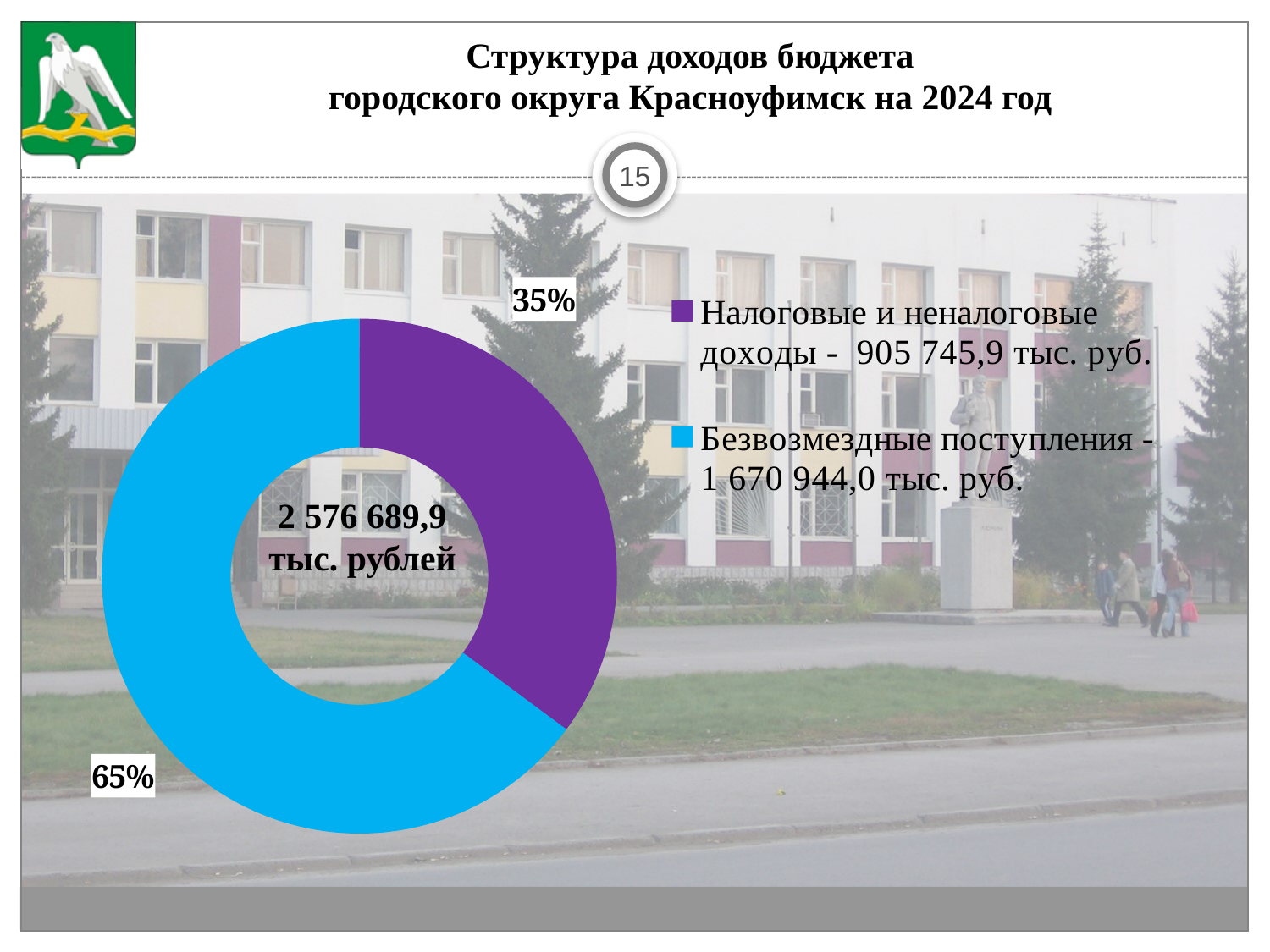
What is the value given in the legend for «Налоговые и неналоговые доходы»? 905 745,9 тыс. руб. What colour is the slice for «Безвозмездные поступления»? Blue Which category has the smallest share of the chart? Налоговые и неналоговые доходы Which is larger: «Безвозмездные поступления» or «Налоговые и неналоговые доходы»? Безвозмездные поступления Which category has the largest share of the chart? Безвозмездные поступления What kind of chart is shown on the slide? Doughnut (pie) chart What is the difference in percentage points between the 65% slice and the 35% slice? 30 percentage points What share of the budget revenue is shown for «Безвозмездные поступления»? 65% How many categories does the chart show? 2 What share of the budget revenue is shown for «Налоговые и неналоговые доходы»? 35% What total is printed in the centre of the doughnut chart? 2 576 689,9 тыс. рублей What is the value given in the legend for «Безвозмездные поступления»? 1 670 944,0 тыс. руб.